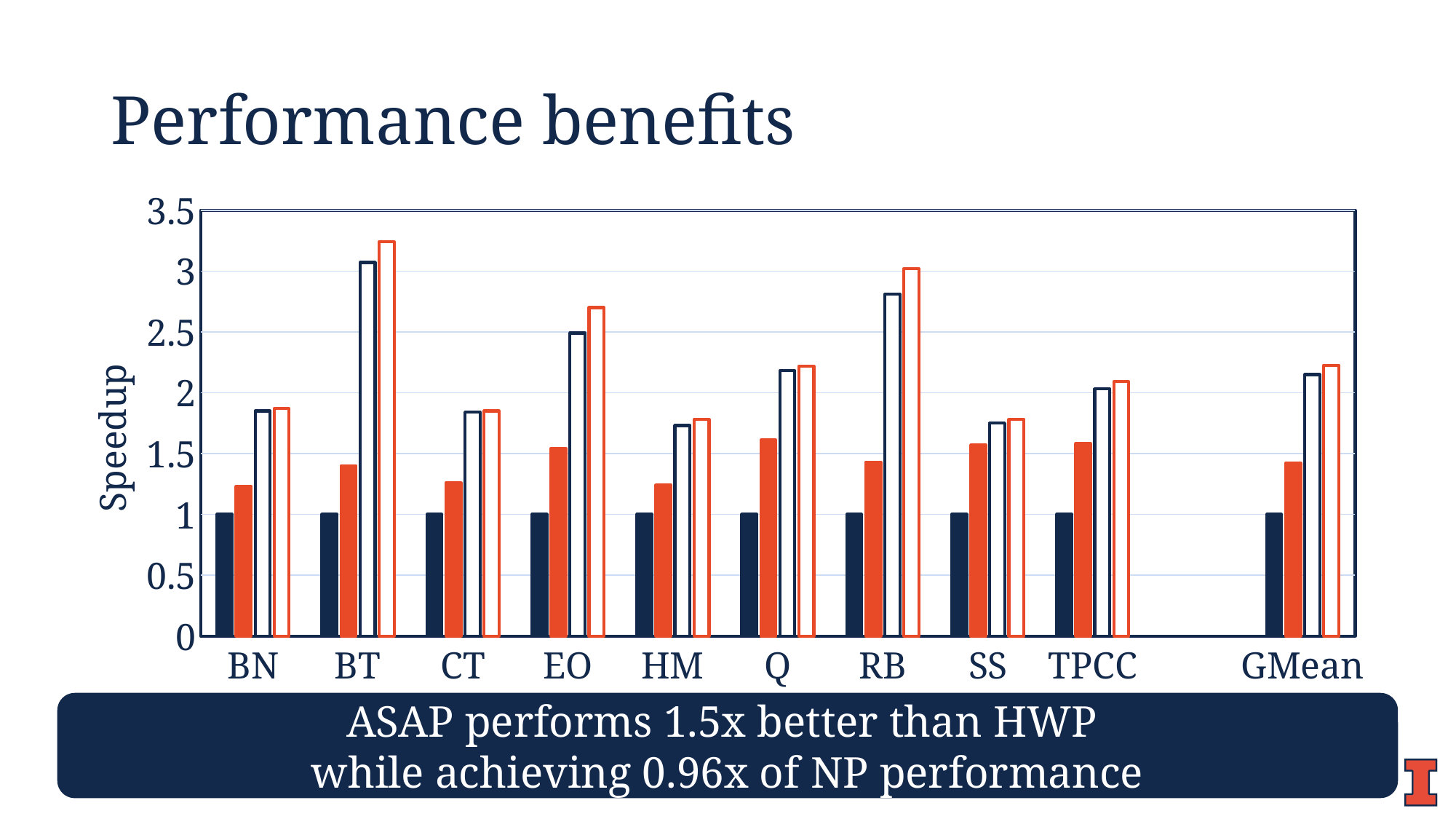
What is the label of the y axis of the chart? Speedup What kind of chart is shown on the slide? bar chart Is the value of the fourth (orange-outlined) bar for GMean greater or less than 2? greater How many categories are shown along the x axis of the chart? 10 Is the value of the fourth (orange-outlined) bar for BT greater or less than 3? greater What is the title of the slide containing the chart? Performance benefits Is the value of the second (orange filled) bar for HM greater or less than 1.5? less What is the value of the first (dark navy) bar for BN? 1 How many bars are plotted for each category in the chart? 4 Which category has the larger tallest bar, BT or CT? BT Which category has the tallest bar in the chart? BT